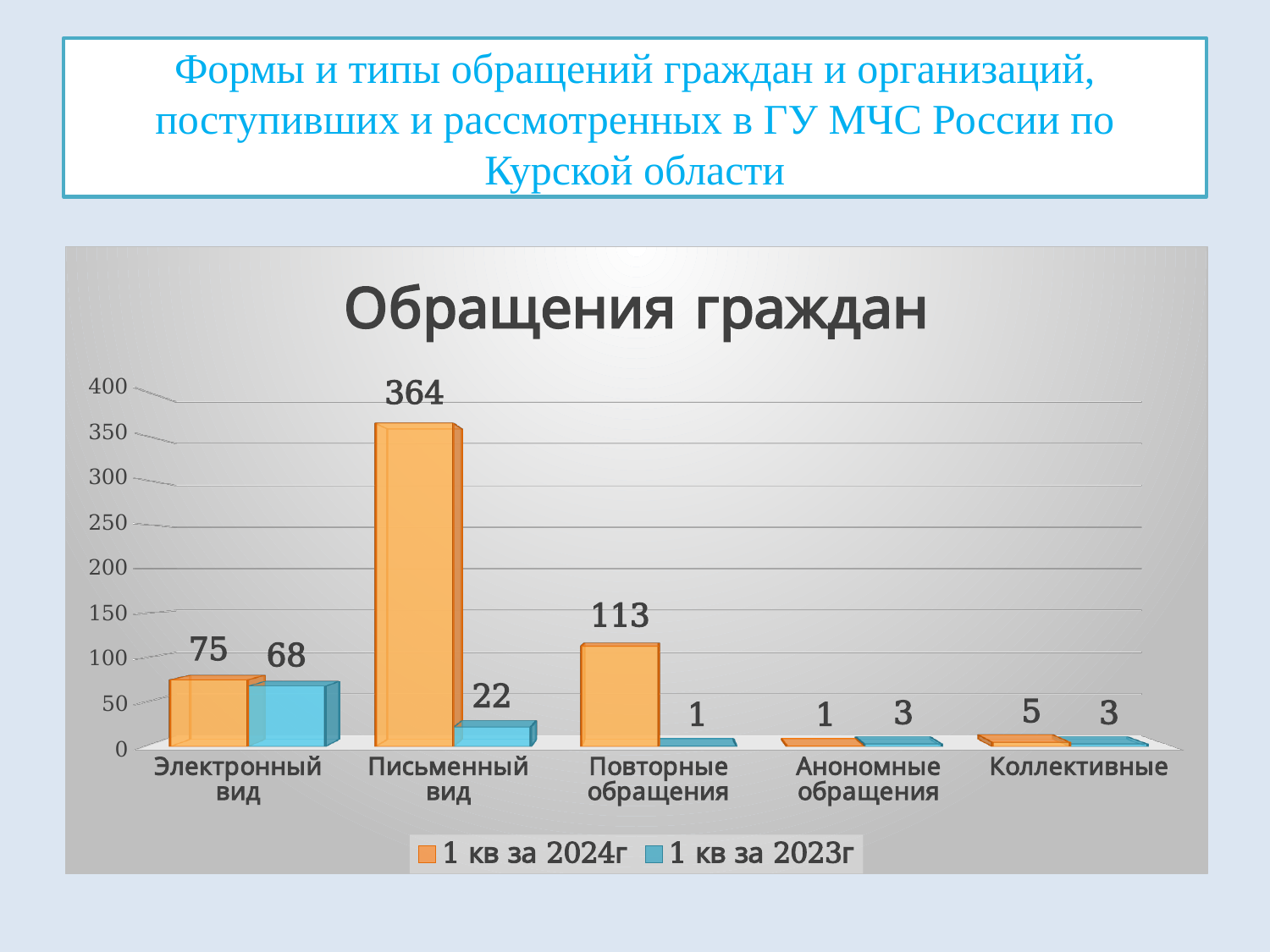
What is the value for Письменный вид in the series 1 кв за 2024г? 364 How many categories are shown on the x axis? 5 What is the value for Повторные обращения in the series 1 кв за 2023г? 1 What is the difference between the 1 кв за 2024г and 1 кв за 2023г values for Письменный вид? 342 How many series does the legend list? 2 What is the title of the chart? Обращения граждан What is the value for Электронный вид in the series 1 кв за 2023г? 68 Which is larger for Анонимные обращения: the value for 1 кв за 2024г or for 1 кв за 2023г? 1 кв за 2023г What kind of chart is shown on the slide? Bar chart Which colour represents the series 1 кв за 2023г? Blue Which category has the lowest value in the series 1 кв за 2024г? Анономные обращения Which category has the highest value in the series 1 кв за 2024г? Письменный вид